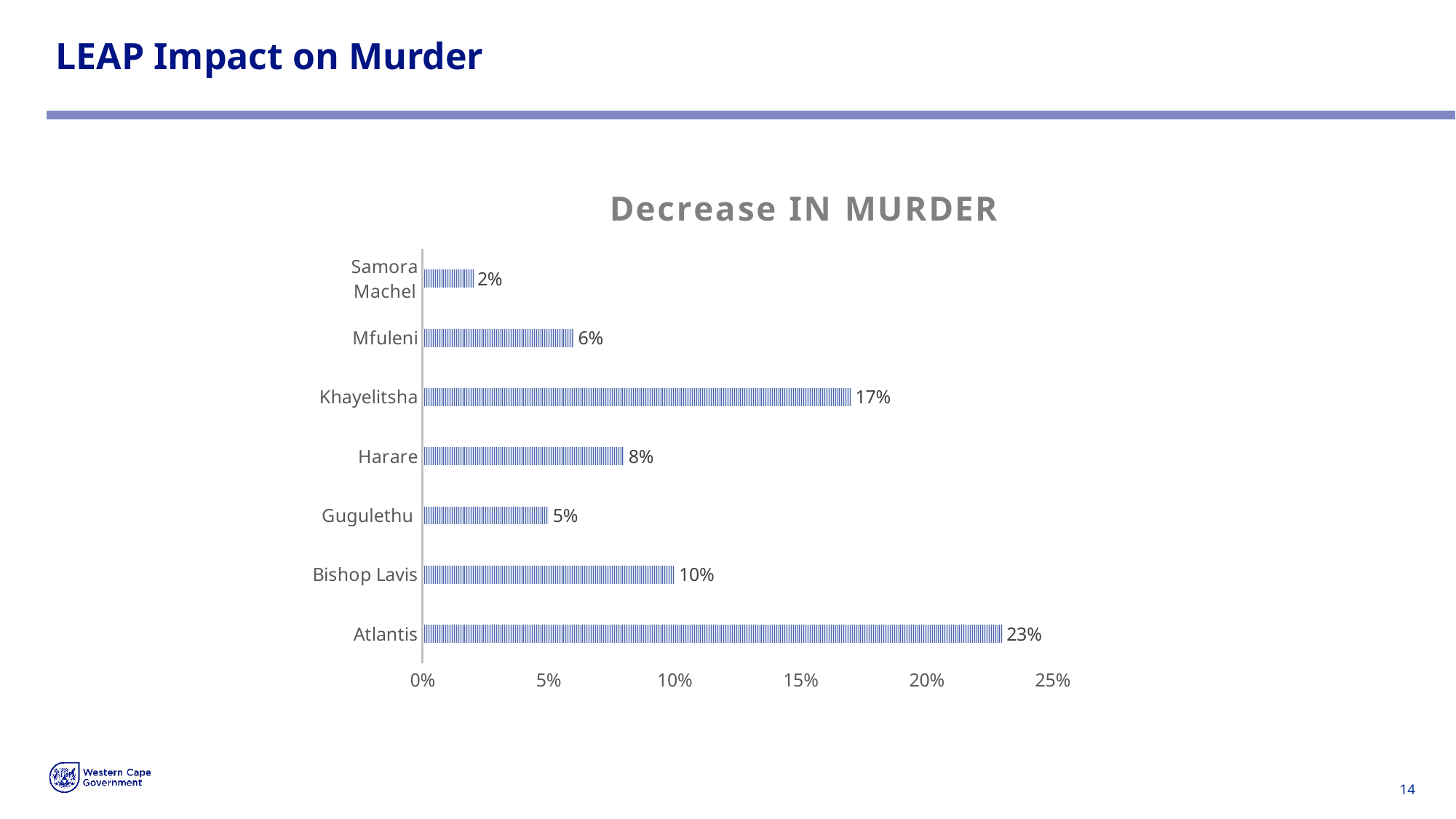
What kind of chart is shown on the slide? Bar chart Which has a larger decrease in murder, Mfuleni or Harare? Harare What is the difference between the decrease in murder for Harare and Gugulethu? 3% How many areas are shown in the chart? 7 What is the title of the chart? Decrease IN MURDER What is the decrease in murder for Khayelitsha? 17% What is the decrease in murder for Atlantis? 23% Which area shows the largest decrease in murder? Atlantis What is the decrease in murder for Samora Machel? 2% What is the decrease in murder for Bishop Lavis? 10% What is the difference between the decrease in murder for Atlantis and Khayelitsha? 6% Which area shows the smallest decrease in murder? Samora Machel